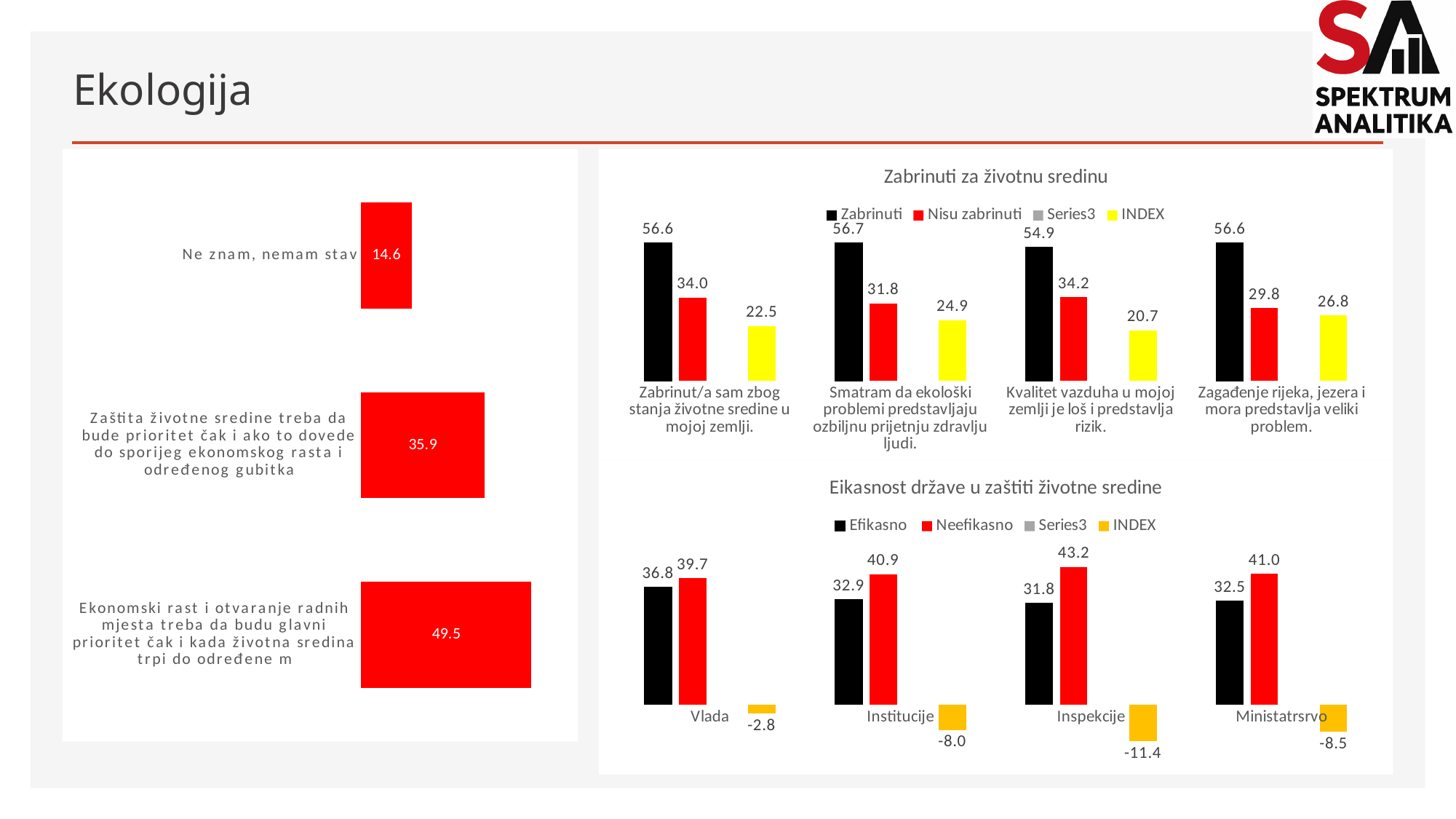
In the left-hand bar chart, what is the difference between the value for "Ekonomski rast i otvaranje radnih mjesta..." (49.5) and "Zaštita životne sredine treba da bude prioritet..." (35.9)? 13.6 In the chart "Eikasnost države u zaštiti životne sredine", is the Efikasno value for Vlada larger or smaller than the Neefikasno value for Vlada? Smaller In the chart "Eikasnost države u zaštiti životne sredine", which category has the lowest INDEX value? Inspekcije In the chart "Eikasnost države u zaštiti životne sredine", what is the Neefikasno value for Inspekcije? 43.2 In the chart "Zabrinuti za životnu sredinu", what is the Zabrinuti value for "Kvalitet vazduha u mojoj zemlji je loš i predstavlja rizik."? 54.9 In the chart "Zabrinuti za životnu sredinu", what is the difference between Zabrinuti (56.7) and Nisu zabrinuti (31.8) for "Smatram da ekološki problemi predstavljaju ozbiljnu prijetnju zdravlju ljudi."? 24.9 What kind of chart is the left-hand chart on the slide? Bar chart In the chart "Zabrinuti za životnu sredinu", how many series does the legend list? 4 In the chart "Eikasnost države u zaštiti životne sredine", how many categories are shown on the x axis? 4 In the left-hand bar chart, which category has the highest value? Ekonomski rast i otvaranje radnih mjesta treba da budu glavni prioritet čak i kada životna sredina trpi do određene m In the chart "Zabrinuti za životnu sredinu", which category has the highest INDEX value? Zagađenje rijeka, jezera i mora predstavlja veliki problem. In the left-hand bar chart, what is the value for "Ne znam, nemam stav"? 14.6